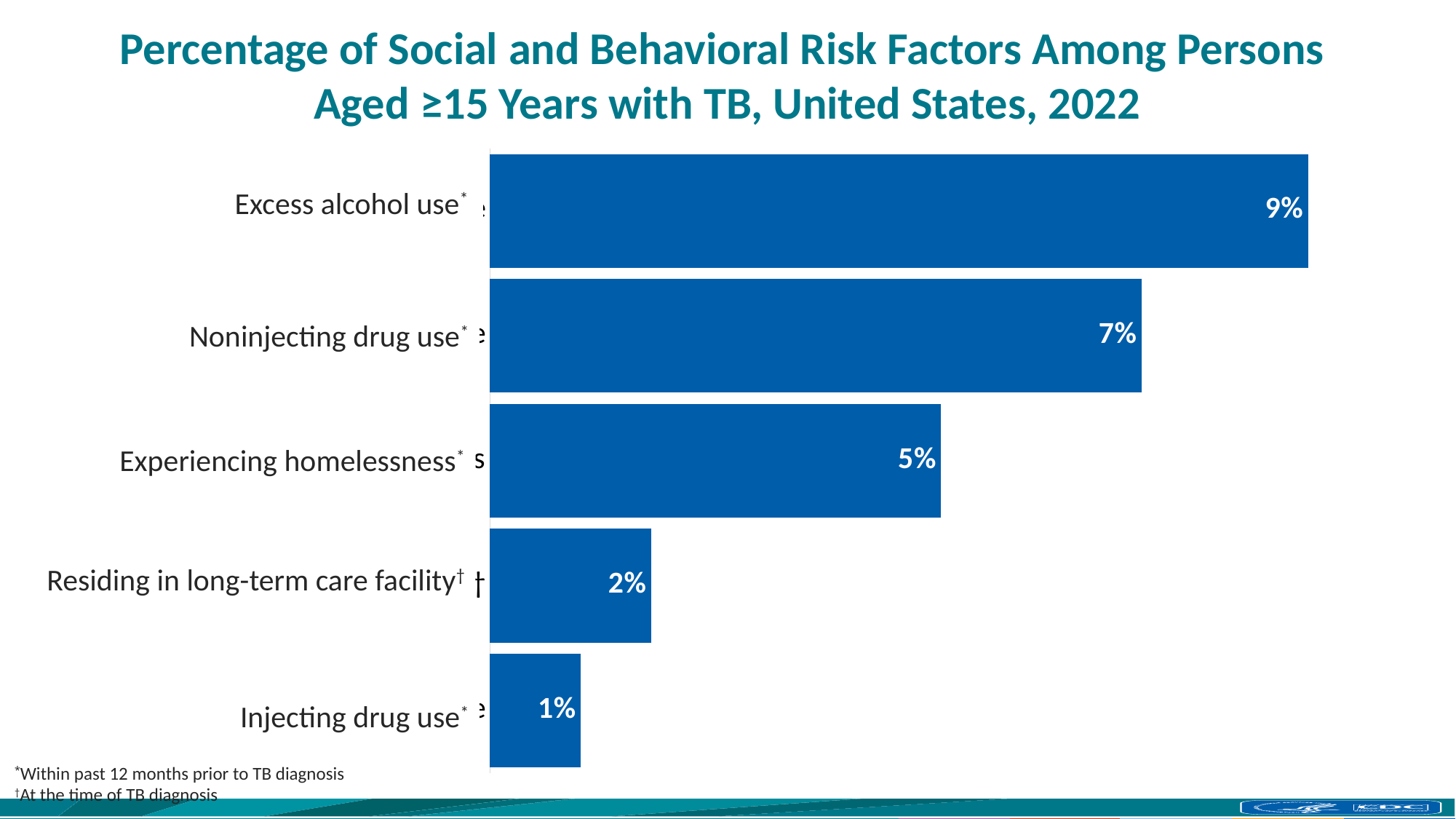
What percentage is shown for Excess alcohol use? 9% Which is larger, the percentage for Experiencing homelessness or for Residing in long-term care facility? Experiencing homelessness What percentage is shown for Experiencing homelessness? 5% What kind of chart is shown on the slide? Bar chart Which risk factor has the highest percentage? Excess alcohol use How many risk factor categories are shown in the chart? 5 What is the difference in percentage points between Excess alcohol use and Noninjecting drug use? 2 What percentage is shown for Residing in long-term care facility? 2% Which risk factor has the lowest percentage? Injecting drug use What percentage is shown for Injecting drug use? 1% What year does the chart title say the data are for? 2022 What percentage is shown for Noninjecting drug use? 7%